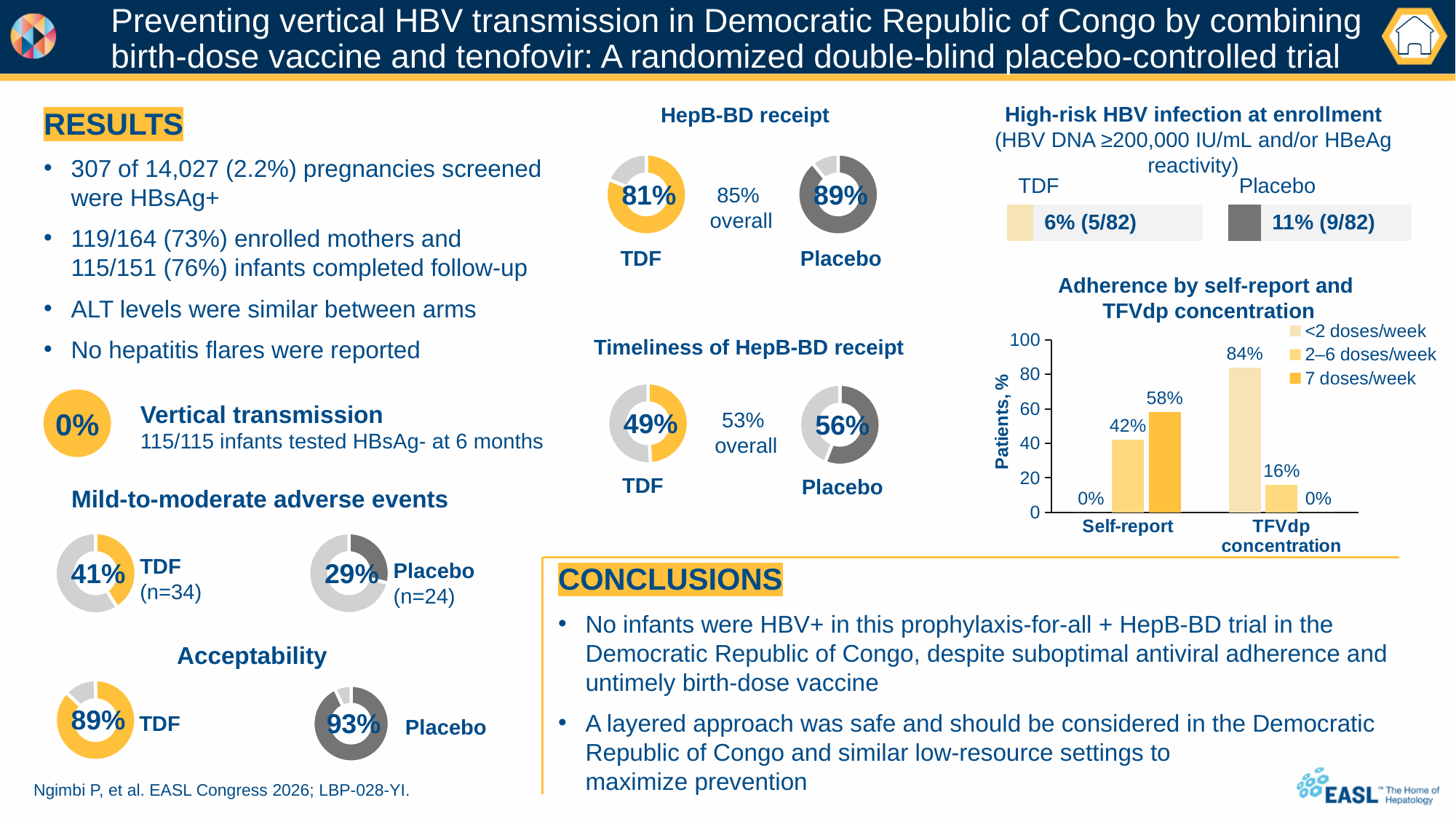
In the 'Adherence by self-report and TFVdp concentration' chart, what is the value for 2–6 doses/week under TFVdp concentration? 16% In the 'Timeliness of HepB-BD receipt' donut charts, what is the difference between the Placebo and TDF values? 7% In the 'Mild-to-moderate adverse events' donut charts, what is the value for TDF? 41% In the 'High-risk HBV infection at enrollment' chart, what is the value for Placebo? 11% (9/82) In the 'Adherence by self-report and TFVdp concentration' chart, what is the value for <2 doses/week under TFVdp concentration? 84% In the 'Adherence by self-report and TFVdp concentration' chart, how many series does the legend list? 3 In the 'Timeliness of HepB-BD receipt' donut charts, which arm has the larger value, TDF or Placebo? Placebo In the 'HepB-BD receipt' donut charts, what is the value for Placebo? 89% In the 'Adherence by self-report and TFVdp concentration' chart, what is the difference between the 7 doses/week and 2–6 doses/week values under Self-report? 16% In the 'Adherence by self-report and TFVdp concentration' chart, what is the value for 7 doses/week under Self-report? 58% What kind of chart is 'Adherence by self-report and TFVdp concentration'? Bar chart In the 'Adherence by self-report and TFVdp concentration' chart, which category has the highest value for <2 doses/week? TFVdp concentration